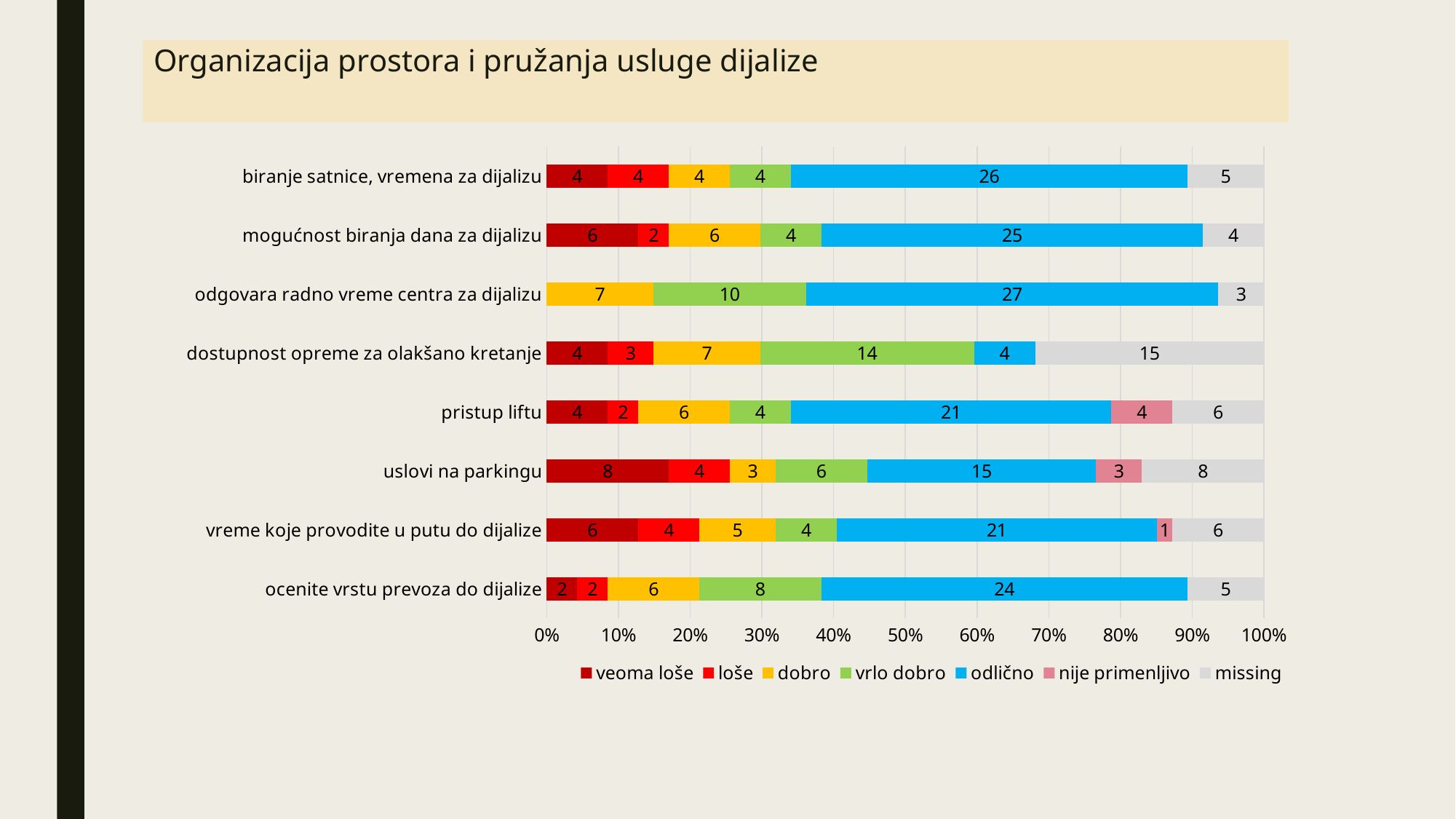
What is the difference between the 'odlično' values for 'biranje satnice, vremena za dijalizu' and 'uslovi na parkingu'? 11 How many categories are plotted on the chart? 8 Which category has the lowest 'odlično' value? dostupnost opreme za olakšano kretanje How many series does the legend list? 7 What is the title of the chart? Organizacija prostora i pružanja usluge dijalize What is the 'missing' value for 'dostupnost opreme za olakšano kretanje'? 15 Which category has the highest 'odlično' value? odgovara radno vreme centra za dijalizu Which is larger: the 'vrlo dobro' value for 'dostupnost opreme za olakšano kretanje' or for 'ocenite vrstu prevoza do dijalize'? dostupnost opreme za olakšano kretanje What is the 'veoma loše' value for 'uslovi na parkingu'? 8 What is the 'odlično' value for 'odgovara radno vreme centra za dijalizu'? 27 What is the total of all segments in the 'pristup liftu' bar? 47 What type of chart is shown on the slide? stacked bar chart